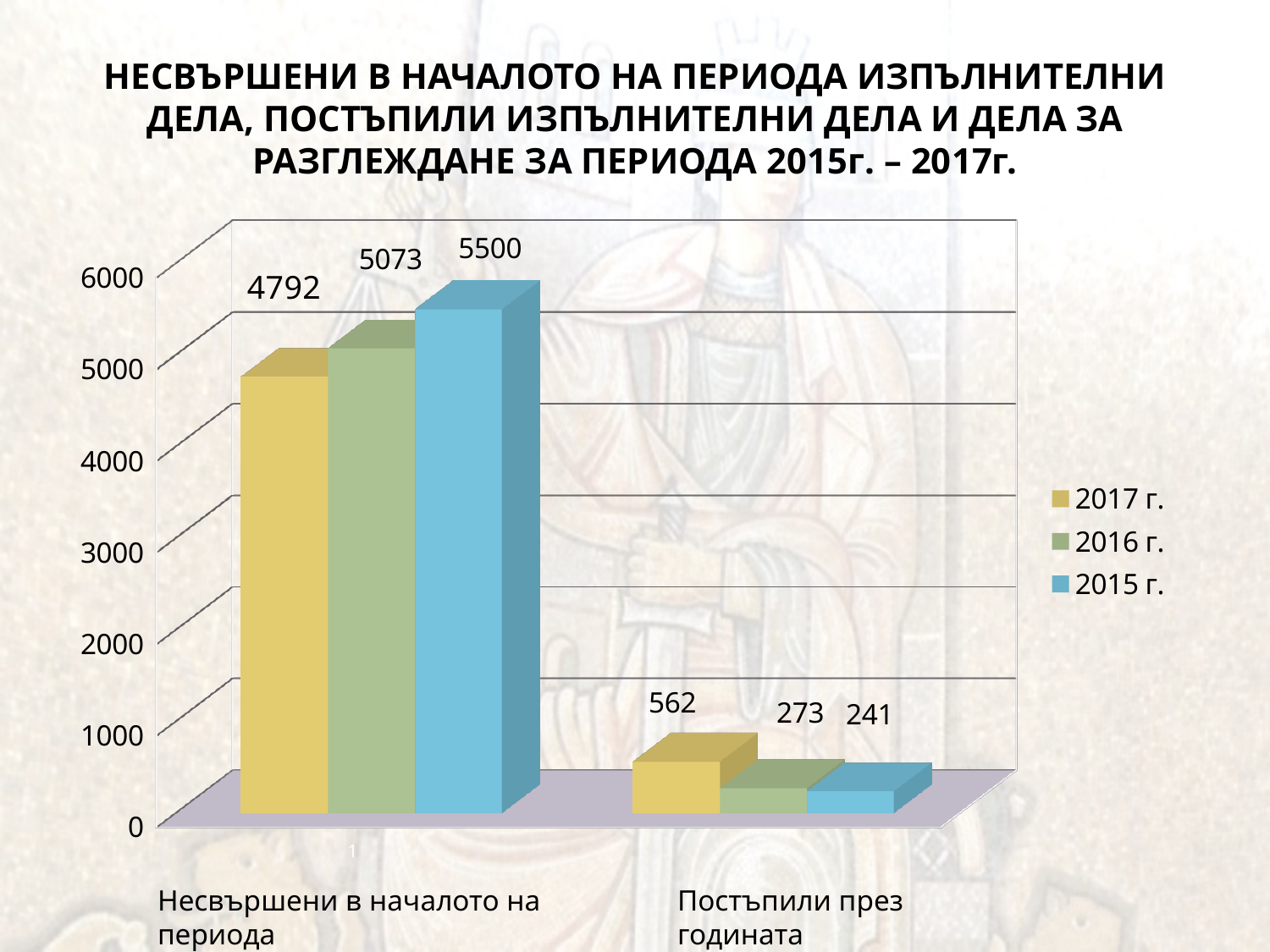
What is the value for 2017 г. in the category "Постъпили през годината"? 562 What kind of chart is shown on the slide? bar chart What is the value for 2016 г. in the category "Несвършени в началото на периода"? 5073 What is the value for 2015 г. in the category "Несвършени в началото на периода"? 5500 What is the difference between the 2015 г. and 2017 г. values in the category "Несвършени в началото на периода"? 708 Which year has the highest value in the category "Несвършени в началото на периода"? 2015 г. Which year has the lowest value in the category "Постъпили през годината"? 2015 г. What is the difference between the 2017 г. and 2016 г. values in the category "Постъпили през годината"? 289 Which is larger: the 2017 г. value for "Несвършени в началото на периода" or the 2016 г. value for the same category? 2016 г. How many categories are shown on the x axis? 2 Is the value for 2017 г. in the category "Постъпили през годината" greater or less than 1000? less How many series does the legend list? 3